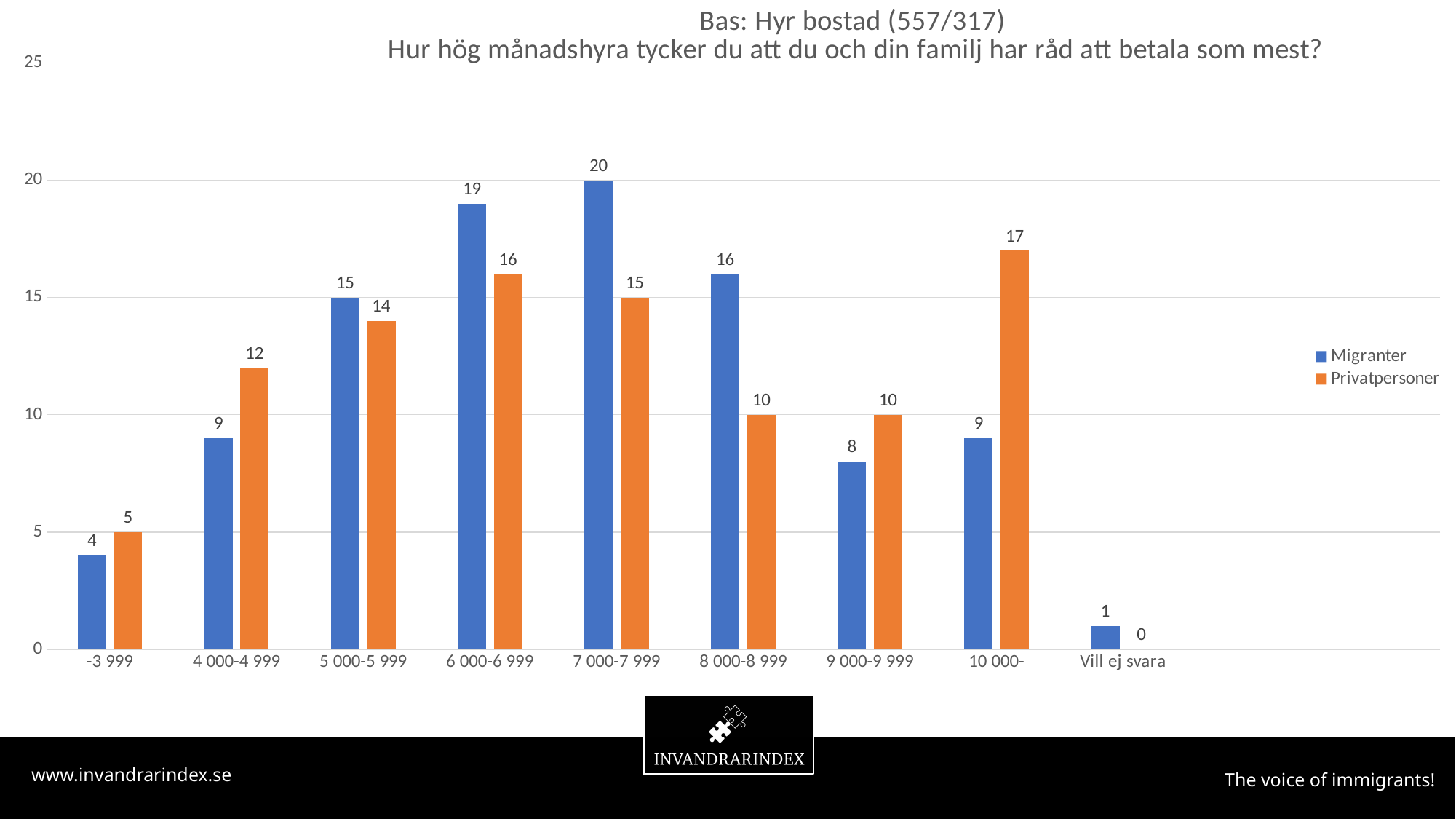
Is the value for Migranter in the 6 000-6 999 category greater or less than 15? greater What kind of chart is shown on the slide? bar chart Which category has the lowest value for Privatpersoner? Vill ej svara Which category has the highest value for Migranter? 7 000-7 999 What is the value for Privatpersoner in the 10 000- category? 17 How many categories are shown on the x axis? 9 What is the value for Privatpersoner in the 4 000-4 999 category? 12 What is the value for Migranter in the 7 000-7 999 category? 20 Which is larger in the 8 000-8 999 category, Migranter or Privatpersoner? Migranter Which series is shown in orange? Privatpersoner What is the difference between Migranter and Privatpersoner in the 10 000- category? 8 How many series does the legend list? 2